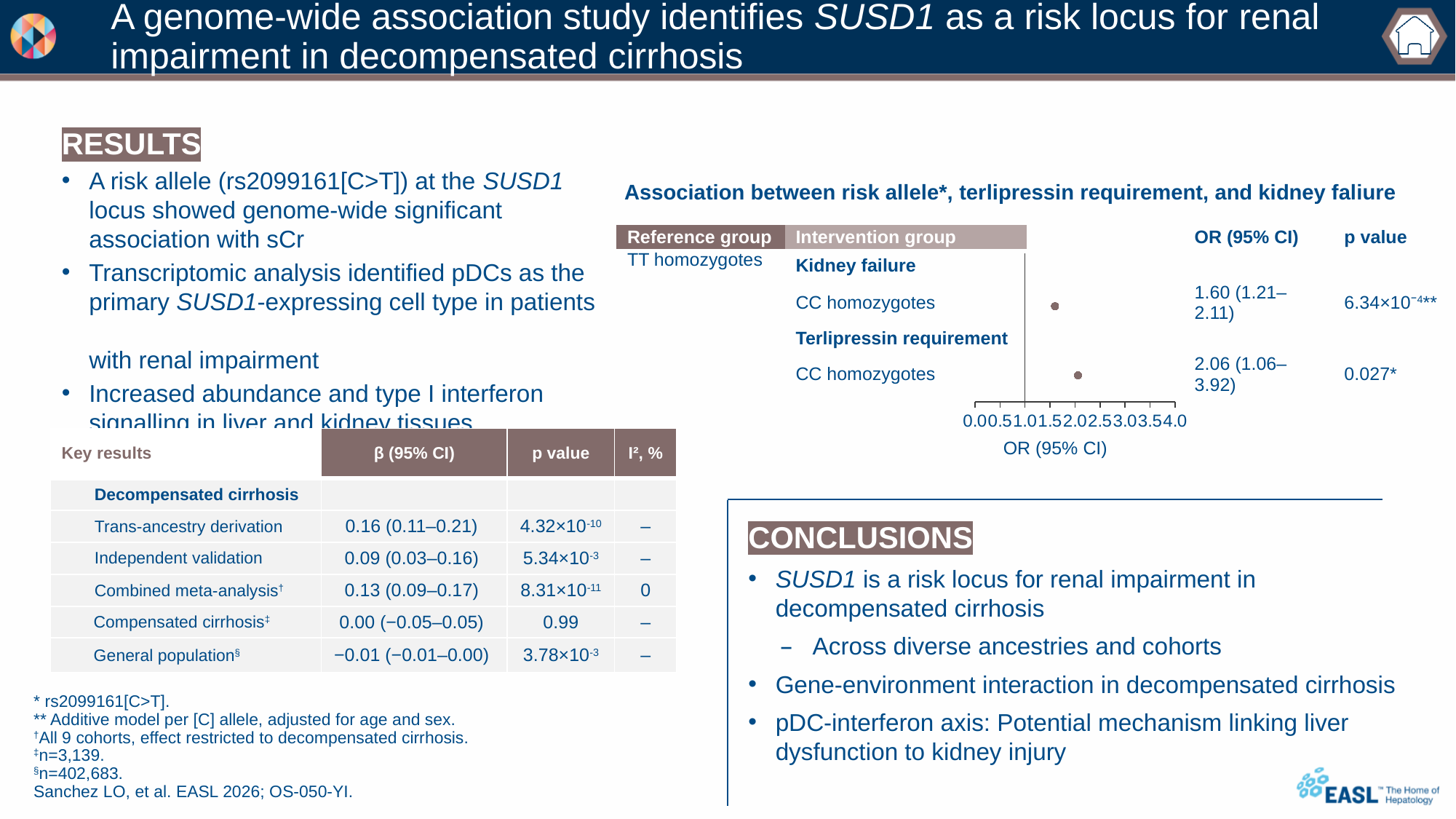
What is the odds ratio for terlipressin requirement in CC homozygotes shown in the forest plot? 2.06 (1.06–3.92) What is the difference between the point estimate odds ratios for terlipressin requirement and kidney failure in the forest plot? 0.46 What is the p value for the kidney failure association in the forest plot? 6.34×10⁻⁴** Which outcome in the forest plot has the lower odds ratio? Kidney failure What is the reference group in the forest plot? TT homozygotes How many data points are plotted in the forest plot? 2 Which outcome in the forest plot has the higher odds ratio, kidney failure or terlipressin requirement? Terlipressin requirement What is the odds ratio for kidney failure in CC homozygotes shown in the forest plot? 1.60 (1.21–2.11) Is the odds ratio point estimate for terlipressin requirement greater or less than 1.0 on the forest plot axis? greater What is the label of the x axis of the forest plot? OR (95% CI) What is the p value for the terlipressin requirement association in the forest plot? 0.027* Is the odds ratio for kidney failure in CC homozygotes larger or smaller than the odds ratio for terlipressin requirement? Smaller